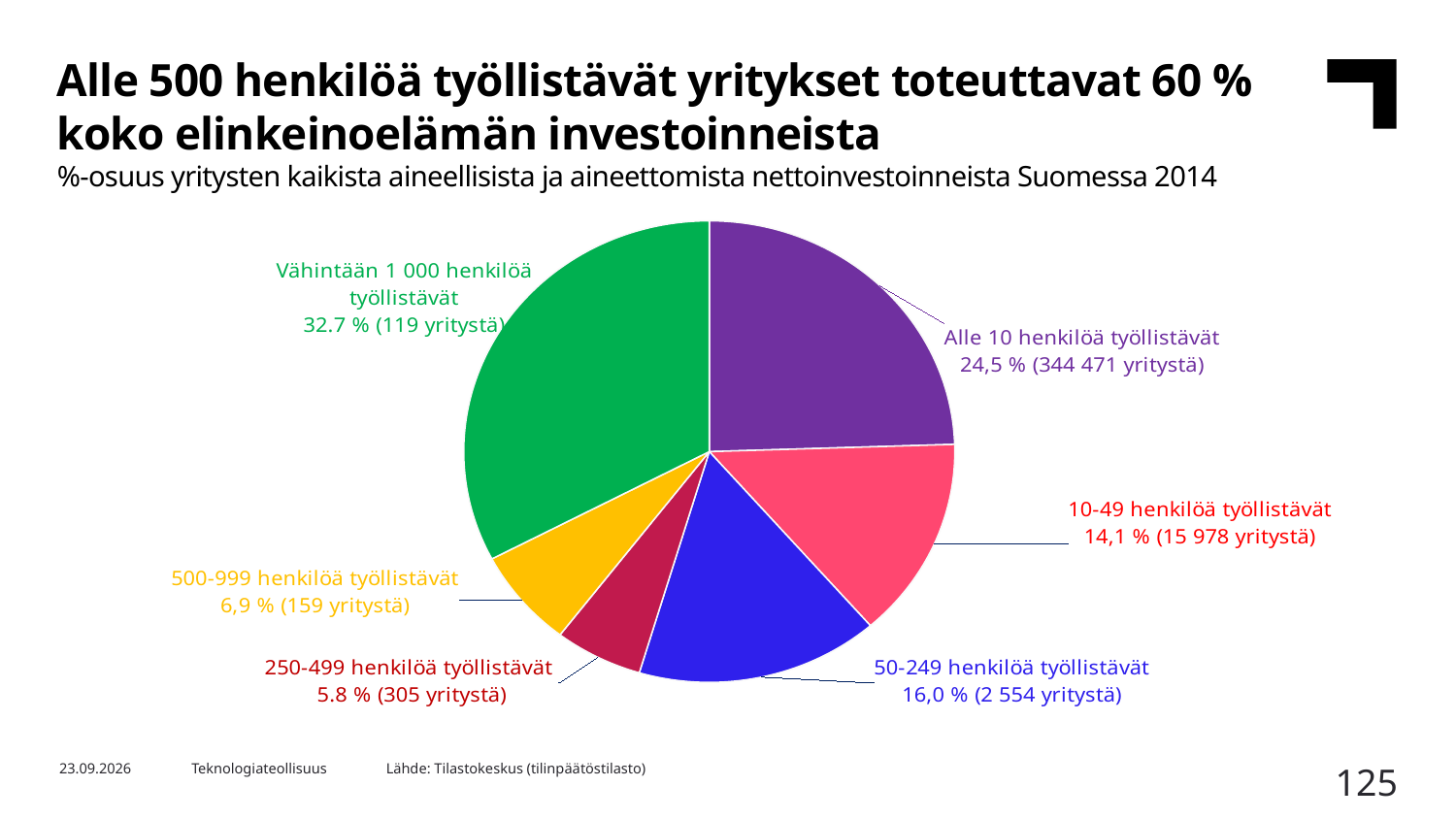
What share of net investments is attributed to companies employing fewer than 10 people (Alle 10 henkilöä työllistävät)? 24,5 % What colour is the slice for Alle 10 henkilöä työllistävät? purple How many slices does the pie chart have? 6 What share of net investments is attributed to companies employing at least 1 000 people (Vähintään 1 000 henkilöä työllistävät)? 32.7 % What is the difference in percentage points between the 50-249 and 10-49 employee categories? 1,9 What percentage is shown for companies employing 50-249 people? 16,0 % How many companies are in the 250-499 henkilöä työllistävät category? 305 Which category has the largest share of the pie? Vähintään 1 000 henkilöä työllistävät How many companies are in the 10-49 henkilöä työllistävät category? 15 978 Which category has the smallest share of the pie? 250-499 henkilöä työllistävät Which has a larger share: 500-999 henkilöä työllistävät or 250-499 henkilöä työllistävät? 500-999 henkilöä työllistävät What kind of chart is shown on the slide? pie chart